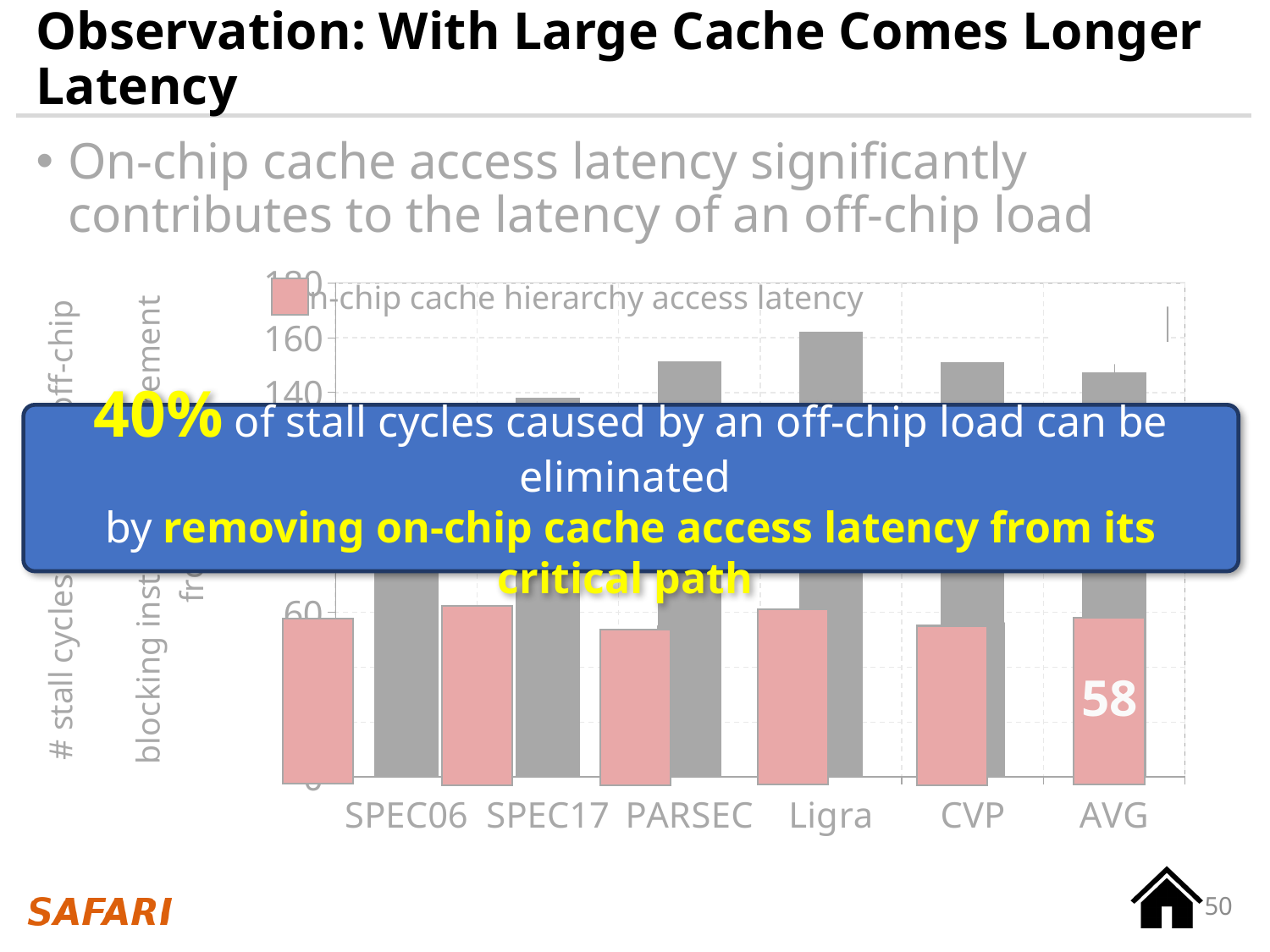
Which category has the tallest gray bar? Ligra For AVG, which bar is taller, the gray bar or the on-chip cache hierarchy access latency bar? the gray bar What type of chart is shown on the slide? bar chart What is the value printed on the on-chip cache hierarchy access latency bar for AVG? 58 How many categories are shown along the x axis of the chart? 6 What is the last category label on the x axis of the chart? AVG Which has the taller gray bar, Ligra or PARSEC? Ligra Is the gray bar for Ligra greater or less than 140? greater What series name is shown in the chart legend? on-chip cache hierarchy access latency Is the on-chip cache hierarchy access latency bar for CVP greater or less than 60? less Is the gray bar for PARSEC greater or less than 140? greater